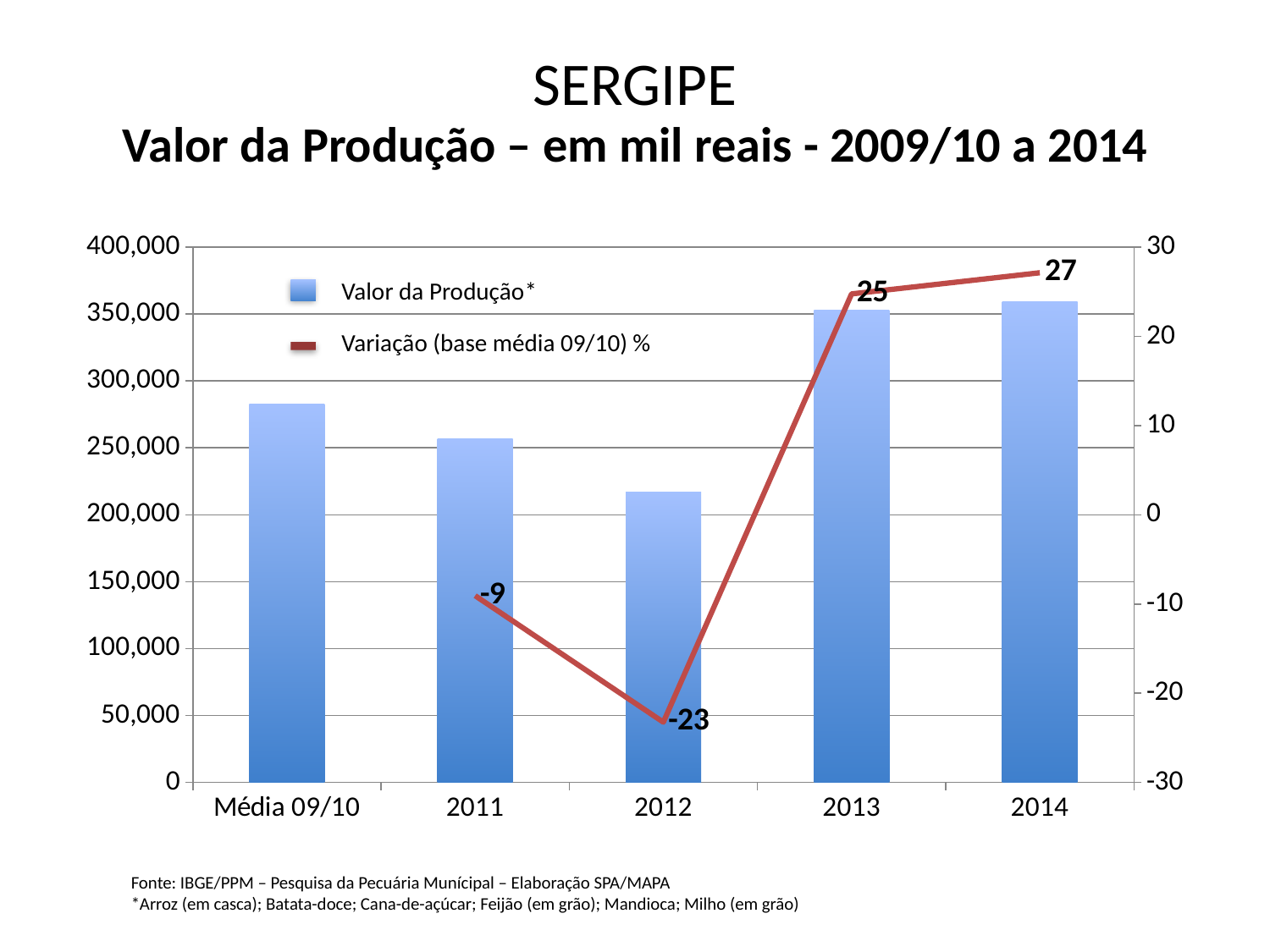
What is the Variação (base média 09/10) % value for 2011? -9 Is the Valor da Produção for 2012 greater or less than 250,000? less What is the difference between the Variação values for 2013 and 2012? 48 Does the Variação (base média 09/10) % line rise or fall from 2012 to 2014? rise Which year has the lowest Variação (base média 09/10) % value? 2012 Which has a larger Valor da Produção, 2013 or 2012? 2013 Which year has the highest Variação (base média 09/10) % value? 2014 What is the Variação (base média 09/10) % value for 2014? 27 How many series does the legend list? 2 How many categories are shown on the x axis? 5 Is the Valor da Produção for 2014 greater or less than 300,000? greater What is the Variação (base média 09/10) % value for 2012? -23